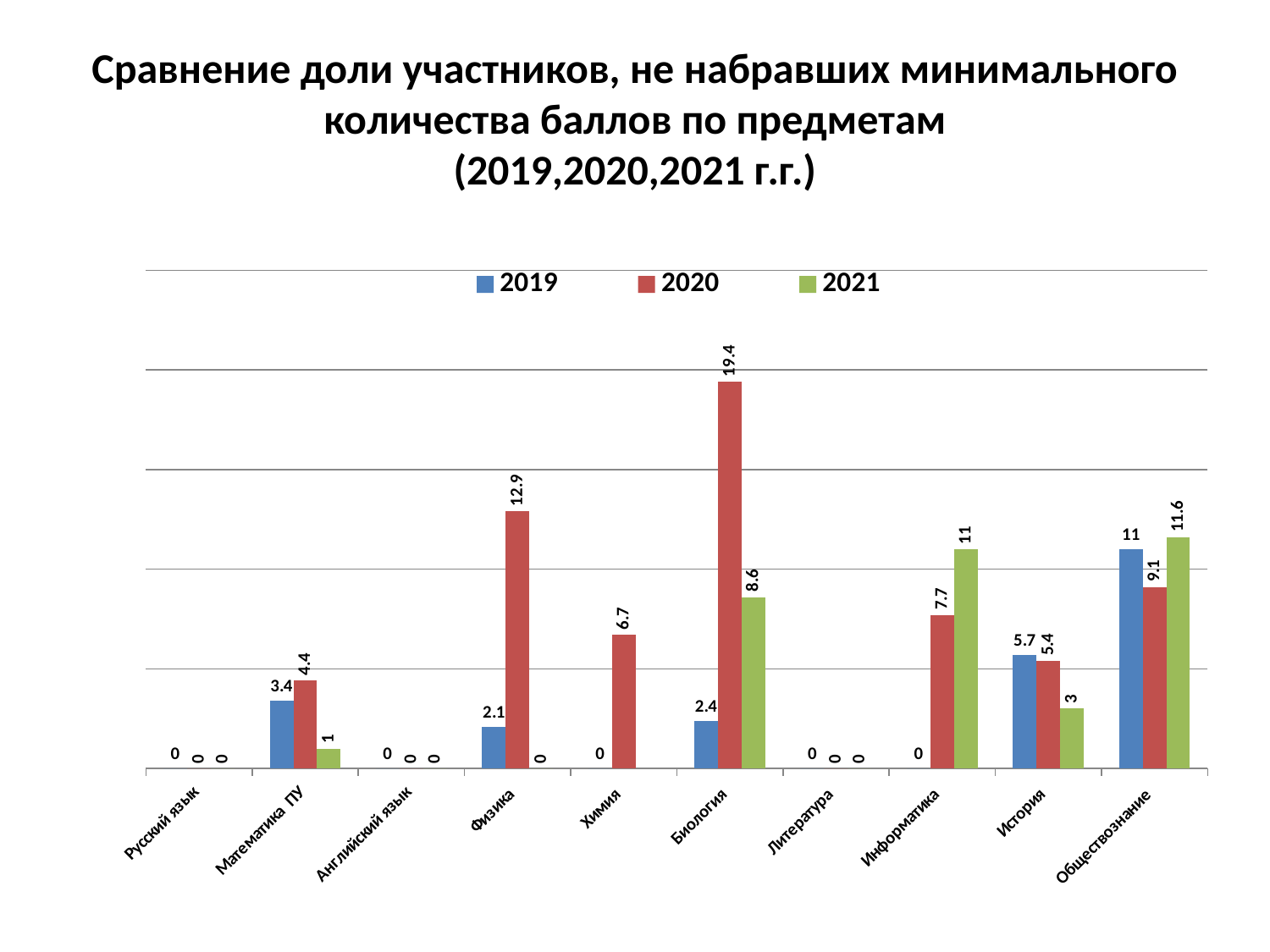
What type of chart is shown on the slide? bar chart What is the difference between the 2020 and 2021 values for Биология? 10.8 Which subject has the highest value in the 2020 series? Биология How many subject categories are shown on the x axis? 10 How many series does the legend list? 3 What is the value for Биология in 2020? 19.4 Which is larger for Обществознание: the 2019 value or the 2020 value? 2019 What is the value for История in 2019? 5.7 What is the value for Физика in 2020? 12.9 What is the value for Информатика in 2021? 11 Which subject has the highest value in the 2021 series? Обществознание Which series is shown in green in the legend? 2021